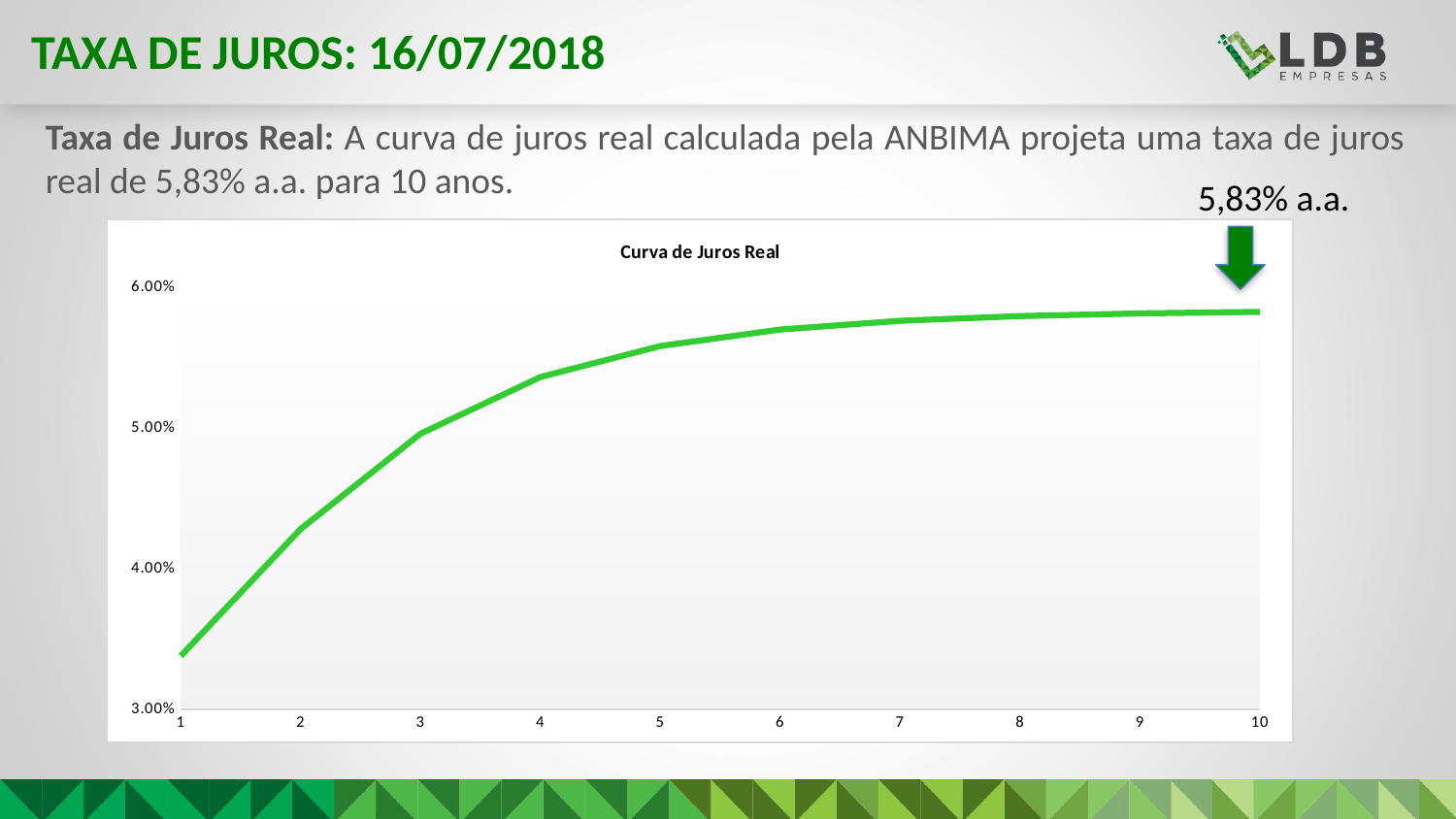
Is the value at x = 1 greater or less than 4.00%? less What is the title of the chart? Curva de Juros Real Is the value at x = 2 greater or less than 4.00%? greater How many points are plotted along the x axis of the chart? 10 Which is larger, the value at x = 2 or the value at x = 6? x = 6 Is the value at x = 4 greater or less than 5.00%? greater What is the projected real interest rate for 10 years, as annotated on the slide? 5,83% a.a. What kind of chart is shown on the slide? Line chart Do the values rise or fall as the x axis goes from 1 to 10? Rise At which x-axis point is the value lowest? 1 At which x-axis point is the value highest? 10